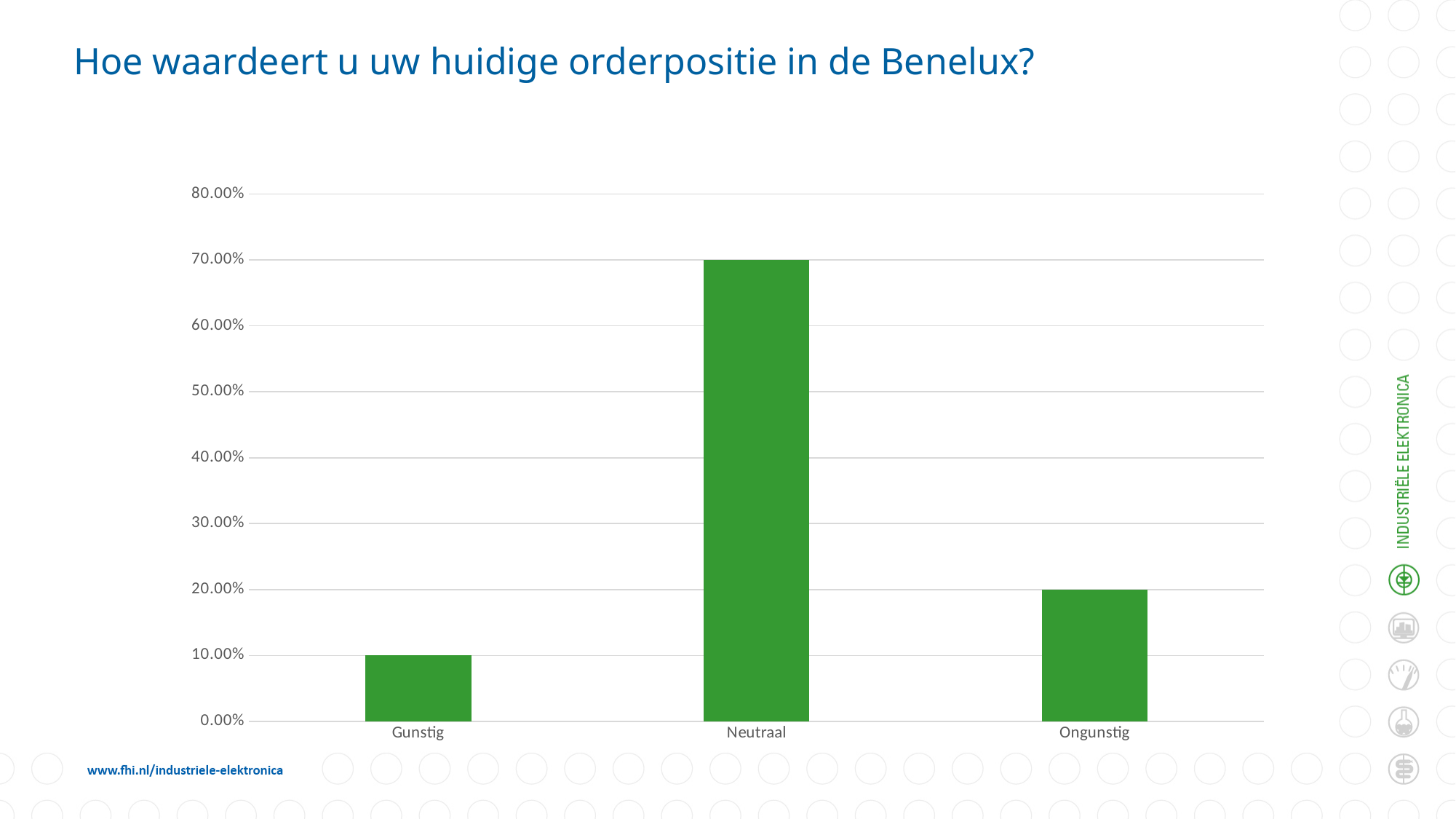
What is the difference between the values for Neutraal and Ongunstig? 50.00% What is the difference between the values for Ongunstig and Gunstig? 10.00% How many categories are shown on the x axis? 3 Which is larger, the value for Gunstig or the value for Ongunstig? Ongunstig Which category has the lowest value? Gunstig What is the value for Ongunstig? 20.00% What is the value for Gunstig? 10.00% What is the value for Neutraal? 70.00% What kind of chart is shown on the slide? bar chart What is the title of the slide containing the chart? Hoe waardeert u uw huidige orderpositie in de Benelux? Is the value for Neutraal greater or less than 60.00%? greater Which category has the highest value? Neutraal